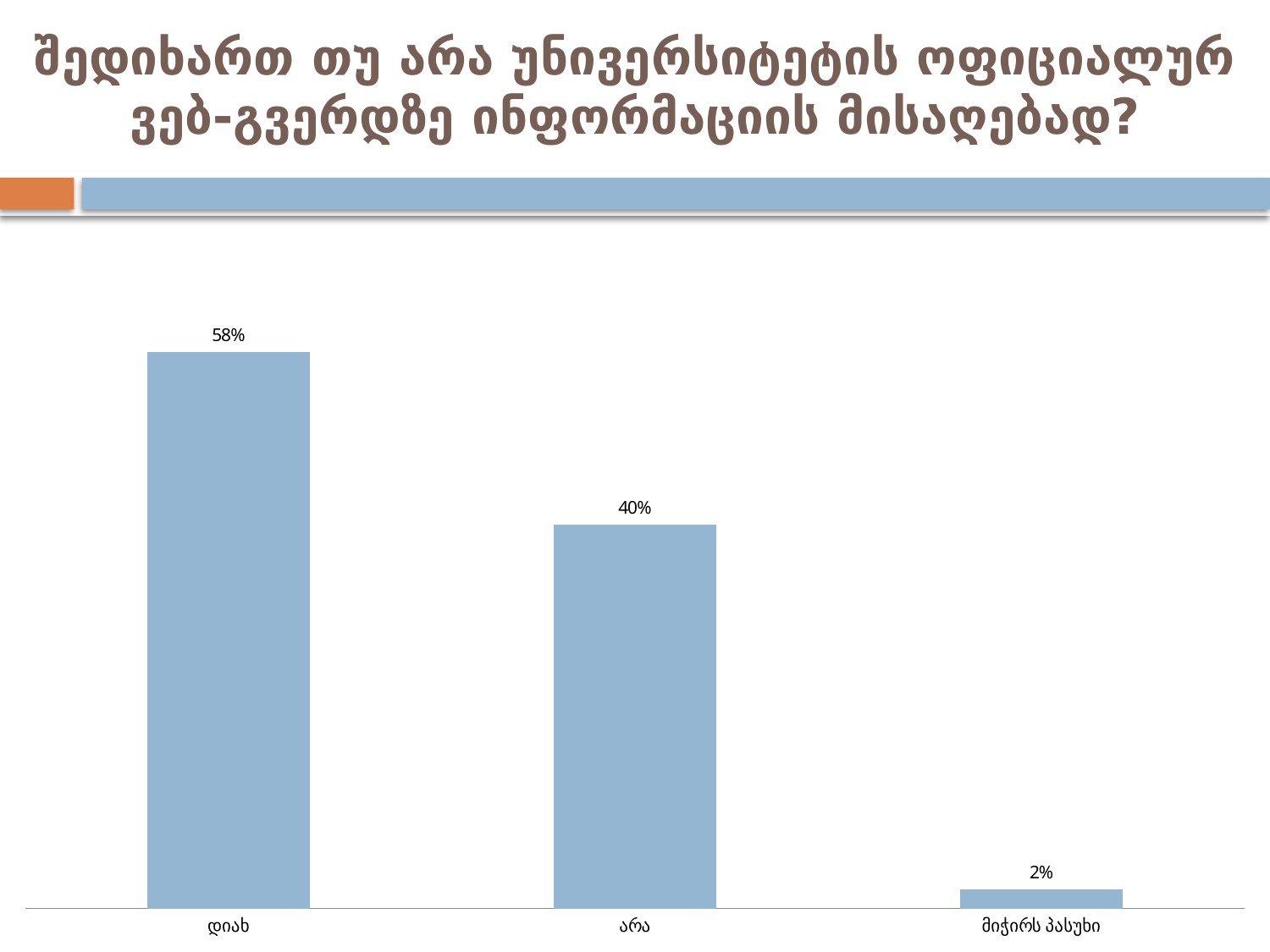
Which is larger, the value for დიახ or the value for არა? დიახ What kind of chart is shown on the slide? bar chart What is the difference between the values for დიახ and არა? 18% Do the values rise or fall from left to right across the categories? fall What is the difference between the values for არა and მიჭირს პასუხი? 38% What colour are the bars in the chart? light blue What is the value for დიახ? 58% Which category has the highest value? დიახ How many categories are shown in the chart? 3 What is the value for არა? 40% Which category has the lowest value? მიჭირს პასუხი What is the value for მიჭირს პასუხი? 2%